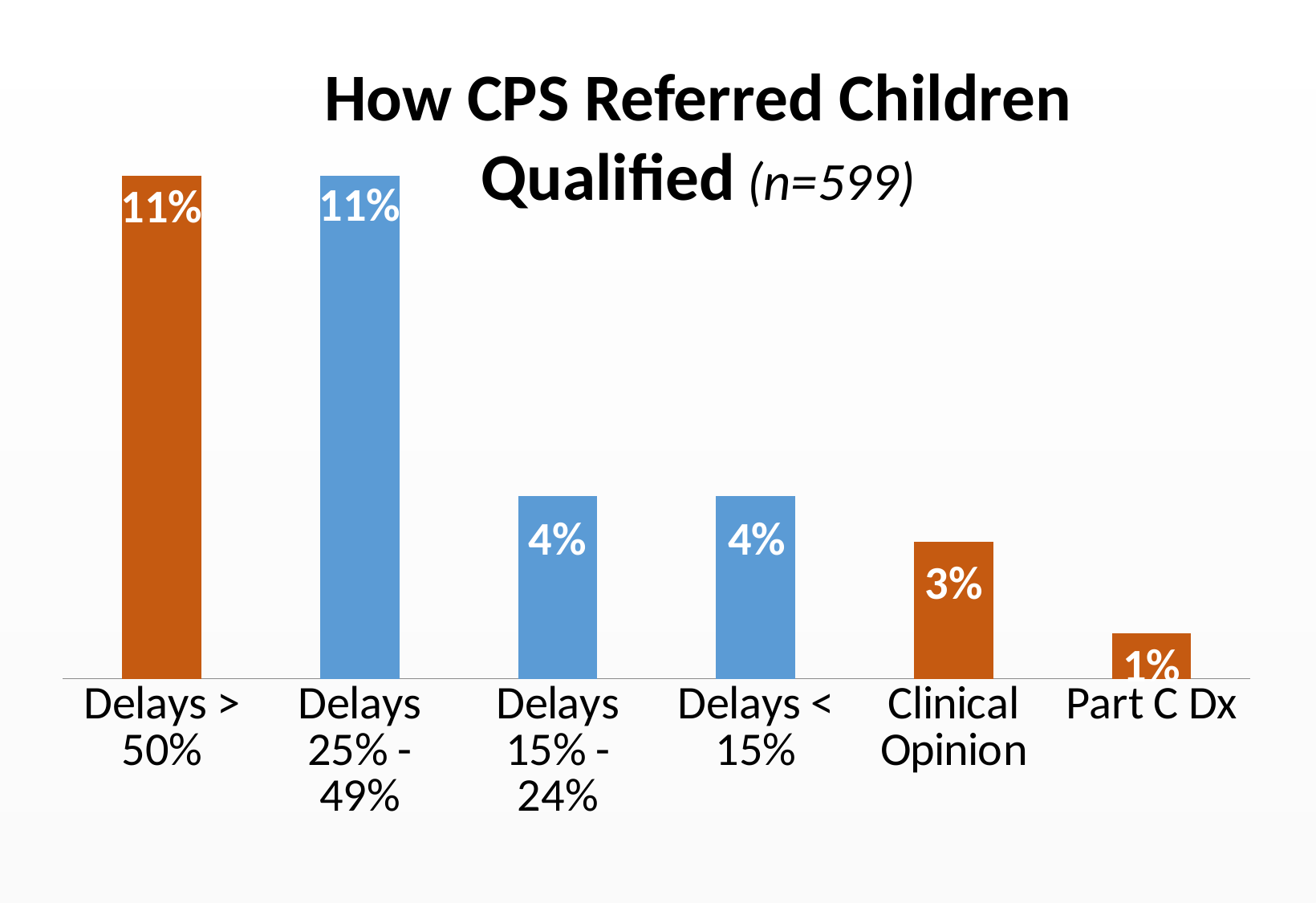
What is the difference between the values for Delays > 50% and Clinical Opinion? 8% What kind of chart is shown on the slide? Bar chart How many categories are shown on the chart? 6 Which is larger, the value for Clinical Opinion or the value for Part C Dx? Clinical Opinion What is the value for Part C Dx? 1% What is the difference between the values for Delays < 15% and Part C Dx? 3% What is the value for Delays 15% - 24%? 4% Which is larger, the value for Delays 25% - 49% or the value for Delays < 15%? Delays 25% - 49% What is the value for Delays > 50%? 11% What is the title of the chart? How CPS Referred Children Qualified (n=599) What is the value for Clinical Opinion? 3% Which category has the lowest value? Part C Dx